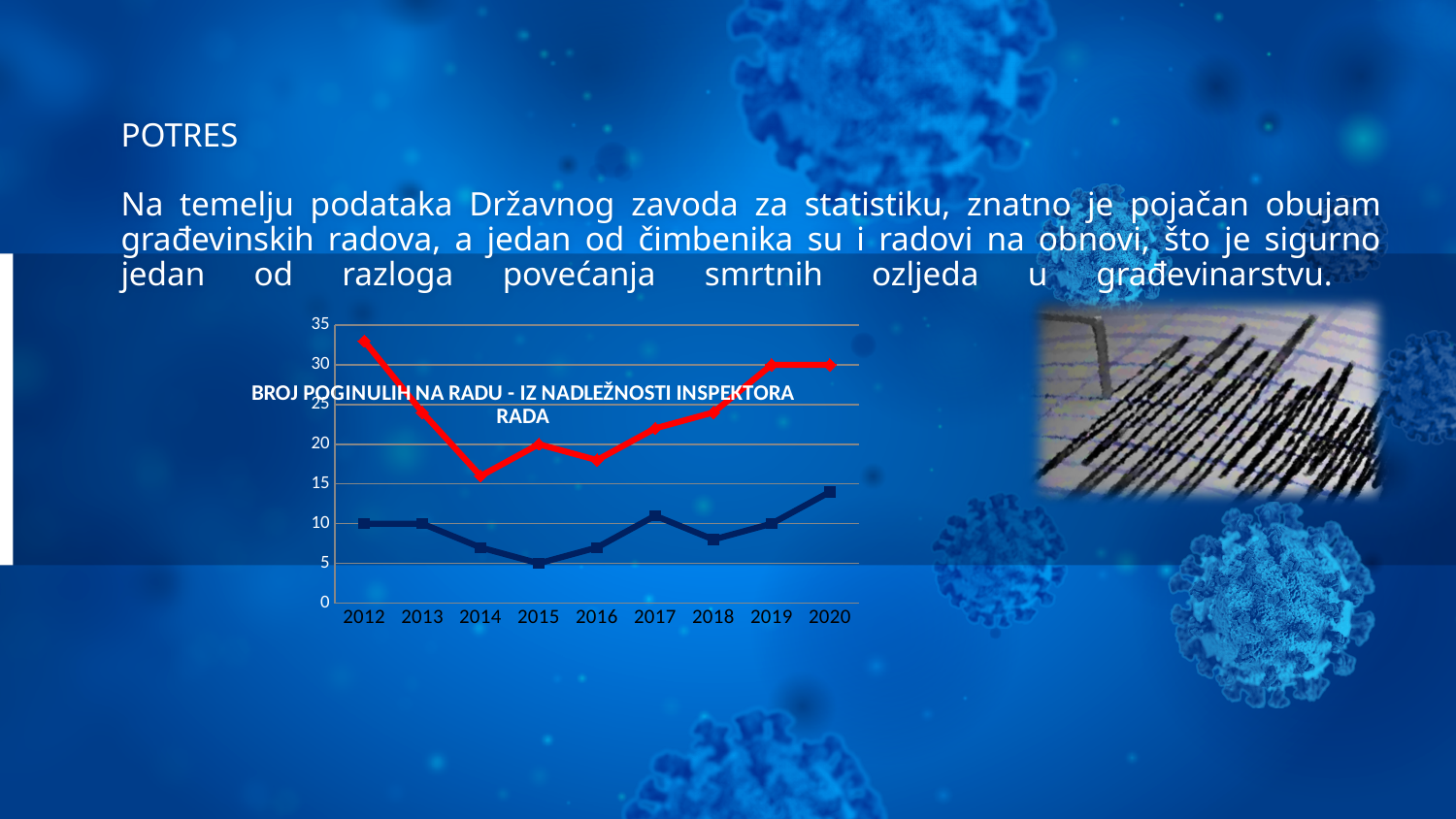
What kind of chart is shown on the slide? line chart Is the value of the dark blue line for 2020 greater or less than 10? greater Is the value of the red line for 2014 greater or less than 20? less Is the value of the red line for 2012 greater or less than 30? greater What is the title of the chart? BROJ POGINULIH NA RADU - IZ NADLEŽNOSTI INSPEKTORA RADA In which year does the red line reach its highest value? 2012 In which year does the red line reach its lowest value? 2014 In 2016, which line has the higher value, the red line or the dark blue line? the red line In which year does the dark blue line reach its lowest value? 2015 How many years are shown on the x axis of the chart? 9 Does the red line rise or fall between 2014 and 2019? rise